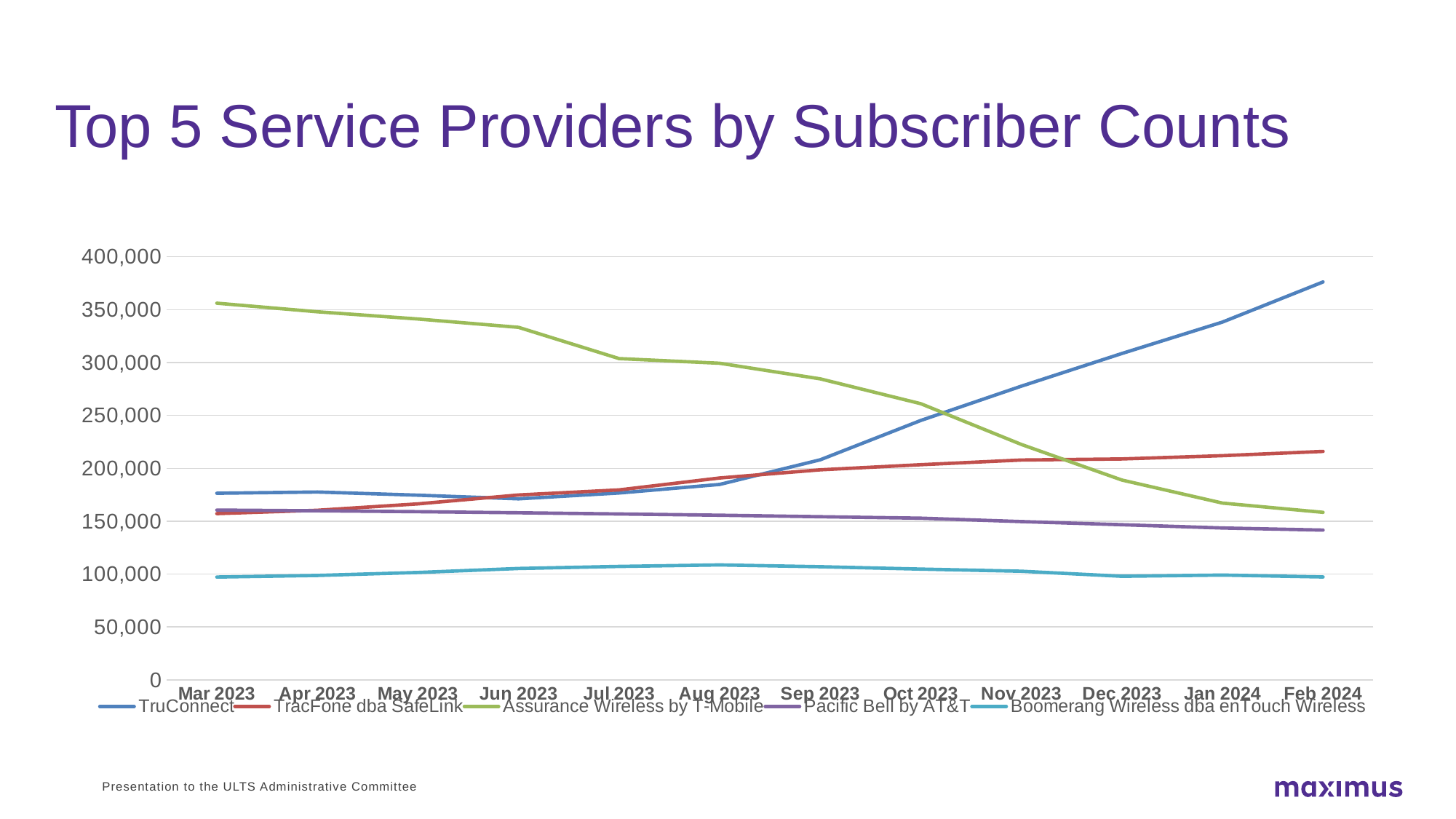
Is the value for TruConnect in Feb 2024 greater or less than 350,000? greater In Feb 2024, which is larger: TracFone dba SafeLink or Pacific Bell by AT&T? TracFone dba SafeLink Is the value for Boomerang Wireless dba enTouch Wireless in Aug 2023 greater or less than 150,000? less Does the Assurance Wireless by T-Mobile line rise or fall from Mar 2023 to Feb 2024? Falls How many months are shown along the x axis? 12 Which service provider has the highest subscriber count in Mar 2023? Assurance Wireless by T-Mobile Is the value for Assurance Wireless by T-Mobile in Feb 2024 greater or less than 200,000? less Which service provider has the lowest subscriber count in Feb 2024? Boomerang Wireless dba enTouch Wireless Which service provider has the highest subscriber count in Feb 2024? TruConnect Does the TruConnect line rise or fall from Mar 2023 to Feb 2024? Rises How many series does the legend list? 5 What kind of chart is shown on the slide? Line chart